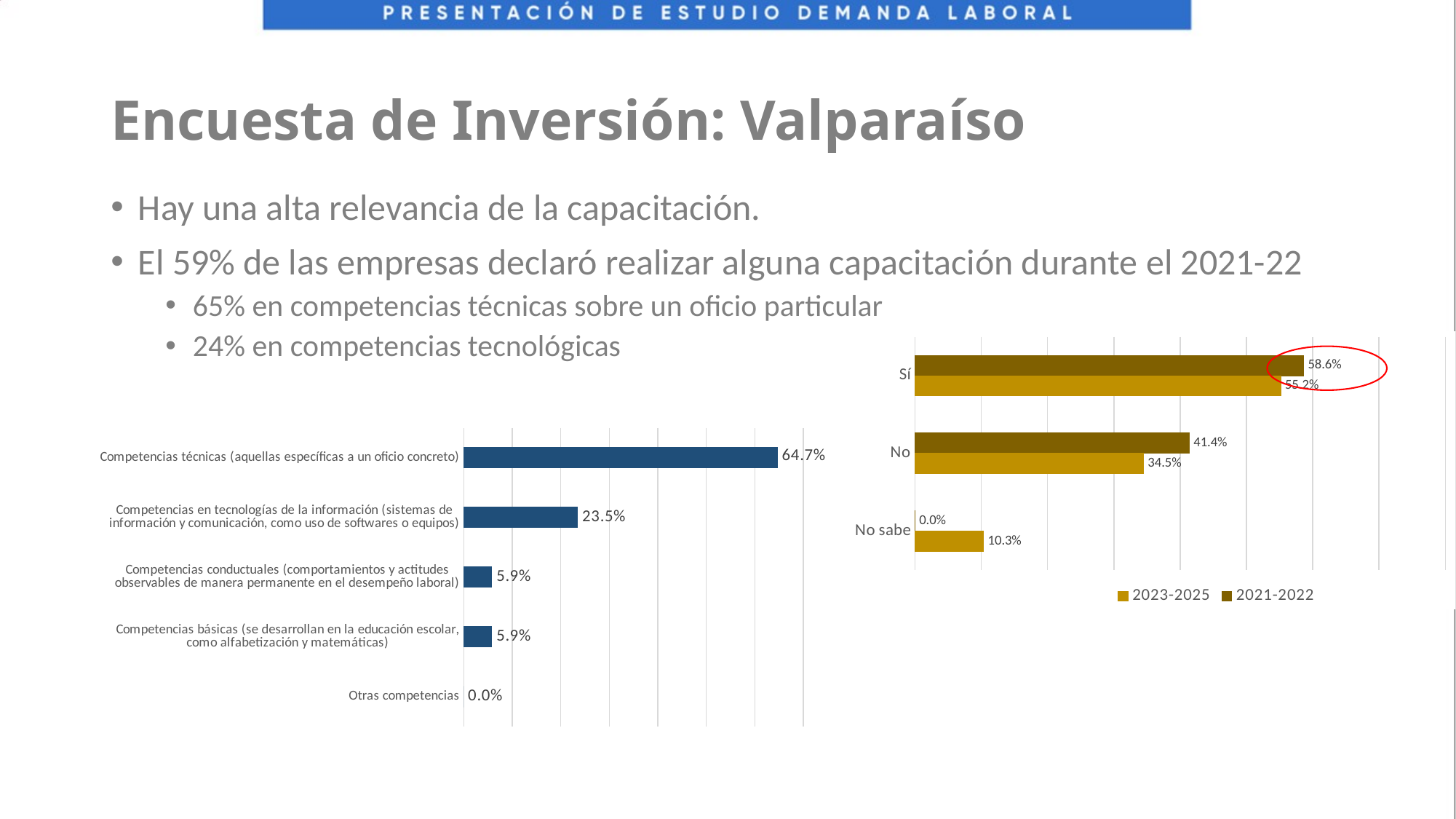
In the chart on the right of the slide, which is larger for No: 2021-2022 or 2023-2025? 2021-2022 In the chart on the left of the slide, which category has the highest value? Competencias técnicas In the chart on the left of the slide, which category has the lowest value? Otras competencias In the chart on the left of the slide, how many categories are shown? 5 In the chart on the right of the slide, what is the difference between the 2021-2022 and 2023-2025 values for No? 6.9% In the chart on the left of the slide, what is the value for Competencias en tecnologías de la información? 23.5% In the chart on the right of the slide, what is the value for No sabe in the 2023-2025 series? 10.3% In the chart on the right of the slide, what is the value for Sí in the 2021-2022 series? 58.6% What kind of chart is shown on the right of the slide? Bar chart In the chart on the right of the slide, how many series does the legend list? 2 In the chart on the left of the slide, what is the difference between Competencias técnicas and Competencias en tecnologías de la información? 41.2% In the chart on the left of the slide, what is the value for Competencias técnicas? 64.7%